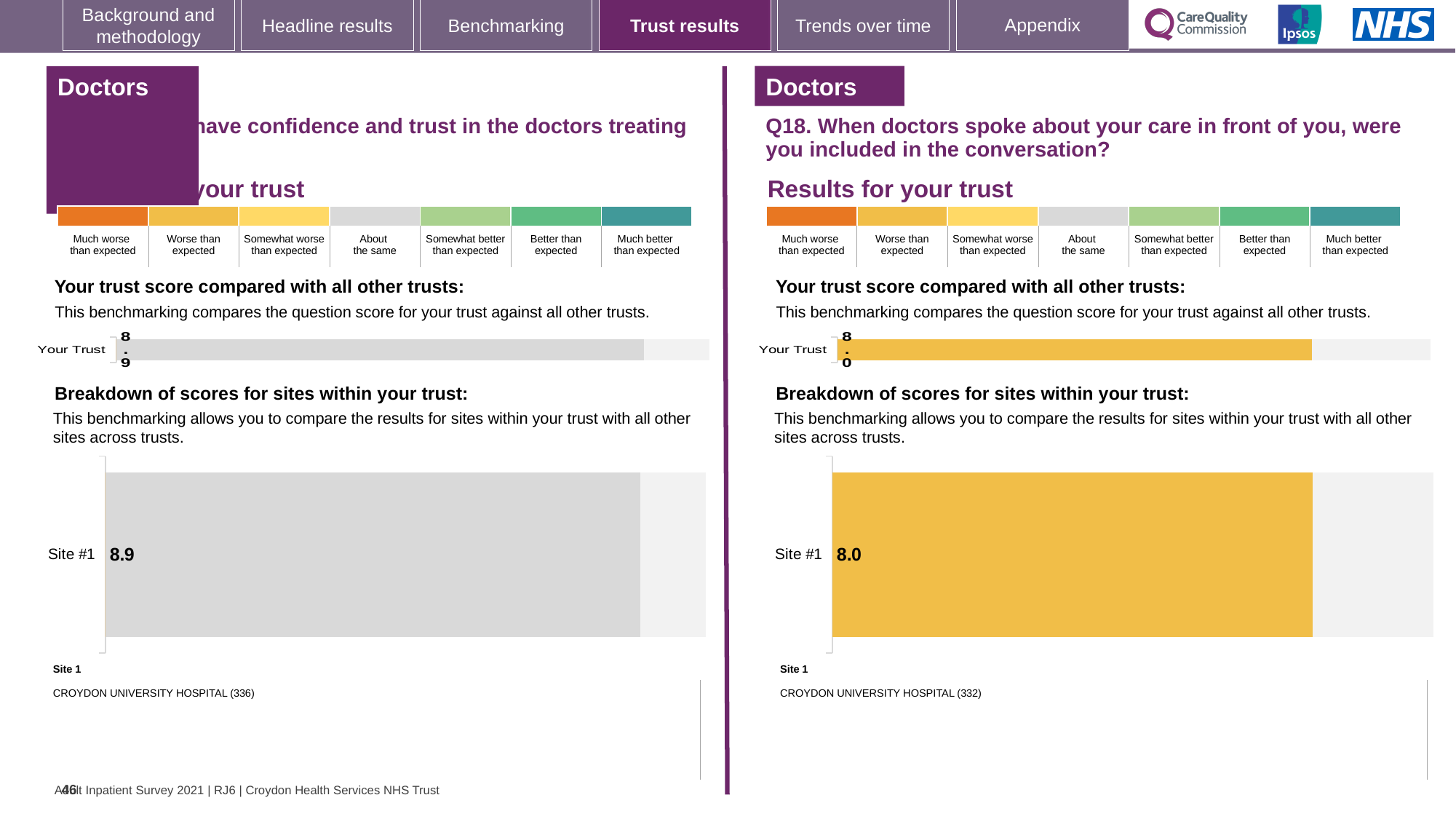
According to the colour key, which benchmark category does the grey Site #1 bar on the left-hand breakdown chart represent? About the same On the left-hand 'Breakdown of scores for sites within your trust' chart, what is the score for Site #1? 8.9 What is the difference between the Site #1 score on the left-hand breakdown chart and the Site #1 score on the right-hand (Q18) breakdown chart? 0.9 Which is larger: the Site #1 score on the left-hand breakdown chart or the Site #1 score on the right-hand (Q18) breakdown chart? Left-hand chart (8.9) On the right-hand 'Breakdown of scores for sites within your trust' chart (Q18), what is the score for Site #1? 8.0 What type of chart is used for the Site #1 breakdown on the right-hand side (Q18)? Bar chart How many sites are shown on the right-hand 'Breakdown of scores for sites within your trust' chart (Q18)? 1 On the left-hand 'Your trust score compared with all other trusts' chart, what is the score for Your Trust? 8.9 On the right-hand 'Your trust score compared with all other trusts' chart (Q18), what is the score for Your Trust? 8.0 Is the Your Trust score on the right-hand (Q18) trust comparison chart greater or less than the Your Trust score on the left-hand trust comparison chart? less How many sites are shown on the left-hand 'Breakdown of scores for sites within your trust' chart? 1 According to the colour key, which benchmark category does the yellow Site #1 bar on the right-hand (Q18) breakdown chart represent? Worse than expected